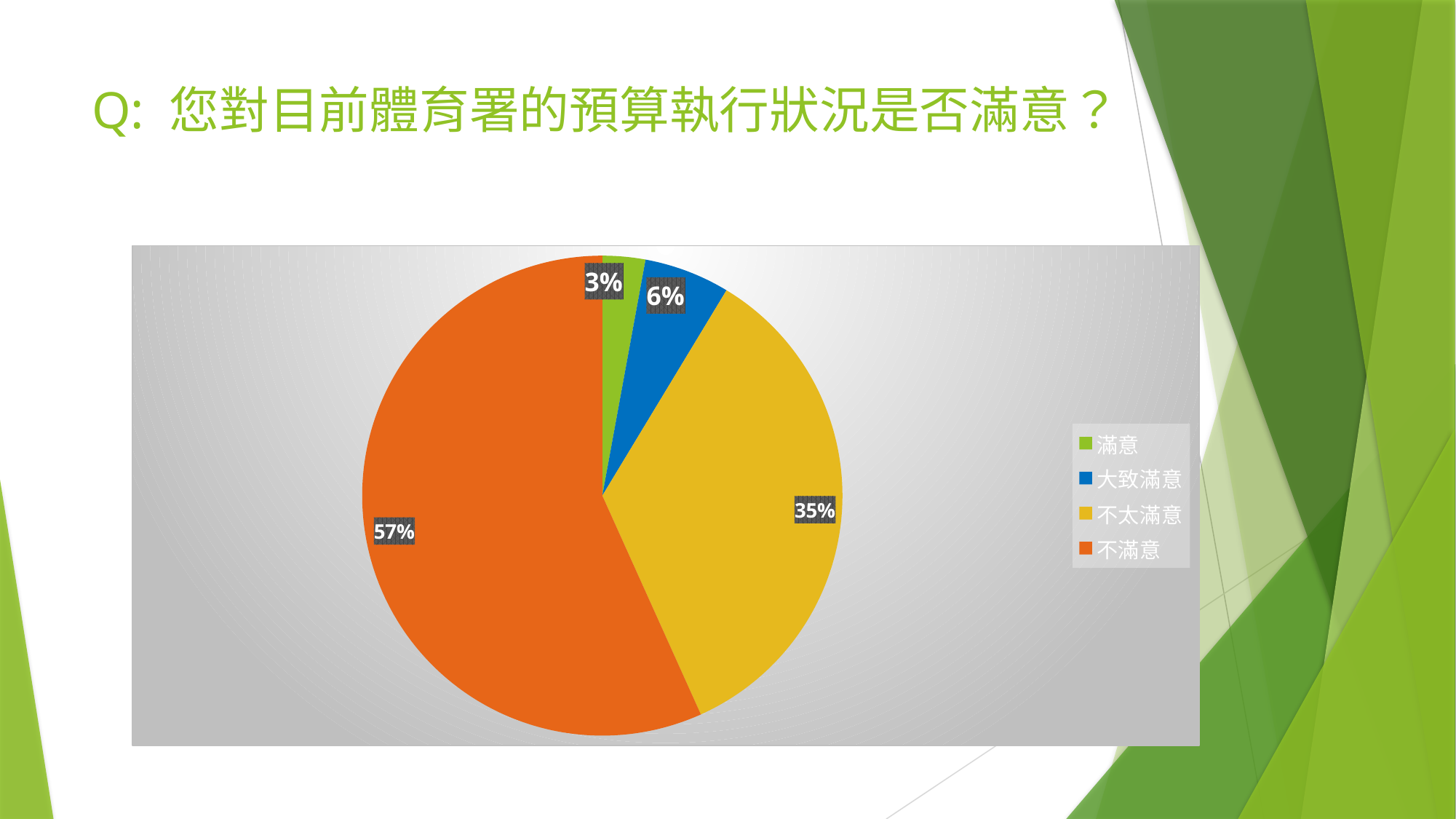
What percentage of the pie is labelled 大致滿意? 6% Which category has the largest slice of the pie? 不滿意 What type of chart is shown on the slide? pie chart What percentage of the pie is labelled 不滿意? 57% Which is larger, the slice for 大致滿意 or the slice for 滿意? 大致滿意 Which category has the smallest slice of the pie? 滿意 How many categories does the pie chart have? 4 What is the combined percentage of 滿意 and 大致滿意? 9% What is the difference in percentage points between 不滿意 and 不太滿意? 22 What percentage of the pie is labelled 滿意? 3% What colour is the slice for 不太滿意? yellow What percentage of the pie is labelled 不太滿意? 35%